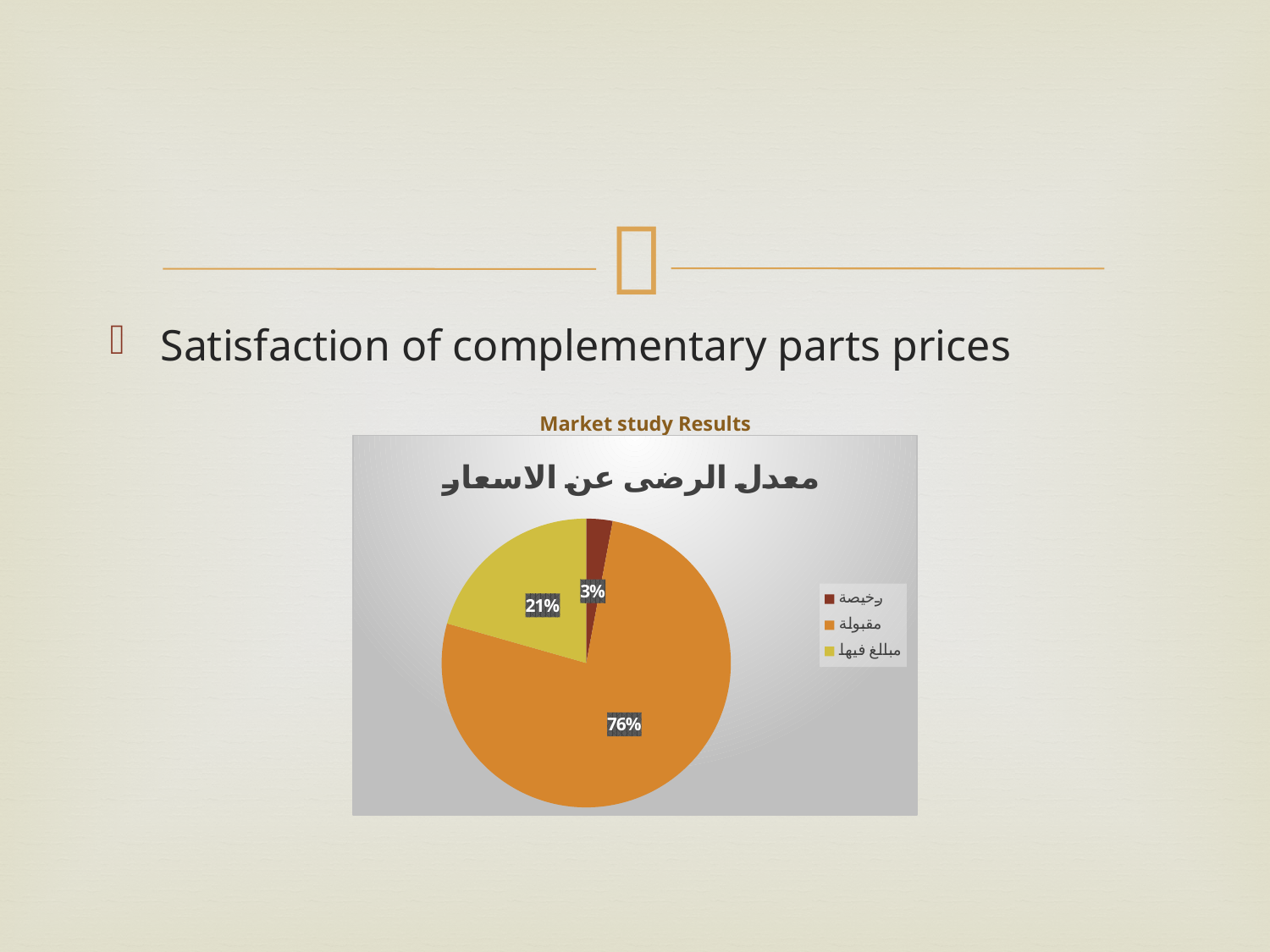
What kind of chart is shown on the slide? Pie chart What share of the pie does the slice labelled مبالغ فيها represent? 21% What is the title of the pie chart? معدل الرضى عن الاسعار How many entries does the legend list? 3 What share of the pie does the slice labelled مقبولة represent? 76% What share of the pie does the slice labelled رخيصة represent? 3% Which category has the largest slice of the pie? مقبولة Which category has the smallest slice of the pie? رخيصة What is the difference in percentage points between the مقبولة slice and the مبالغ فيها slice? 55 What colour is the slice labelled مبالغ فيها? Yellow How many slices does the pie chart have? 3 Which slice is larger, مبالغ فيها or رخيصة? مبالغ فيها